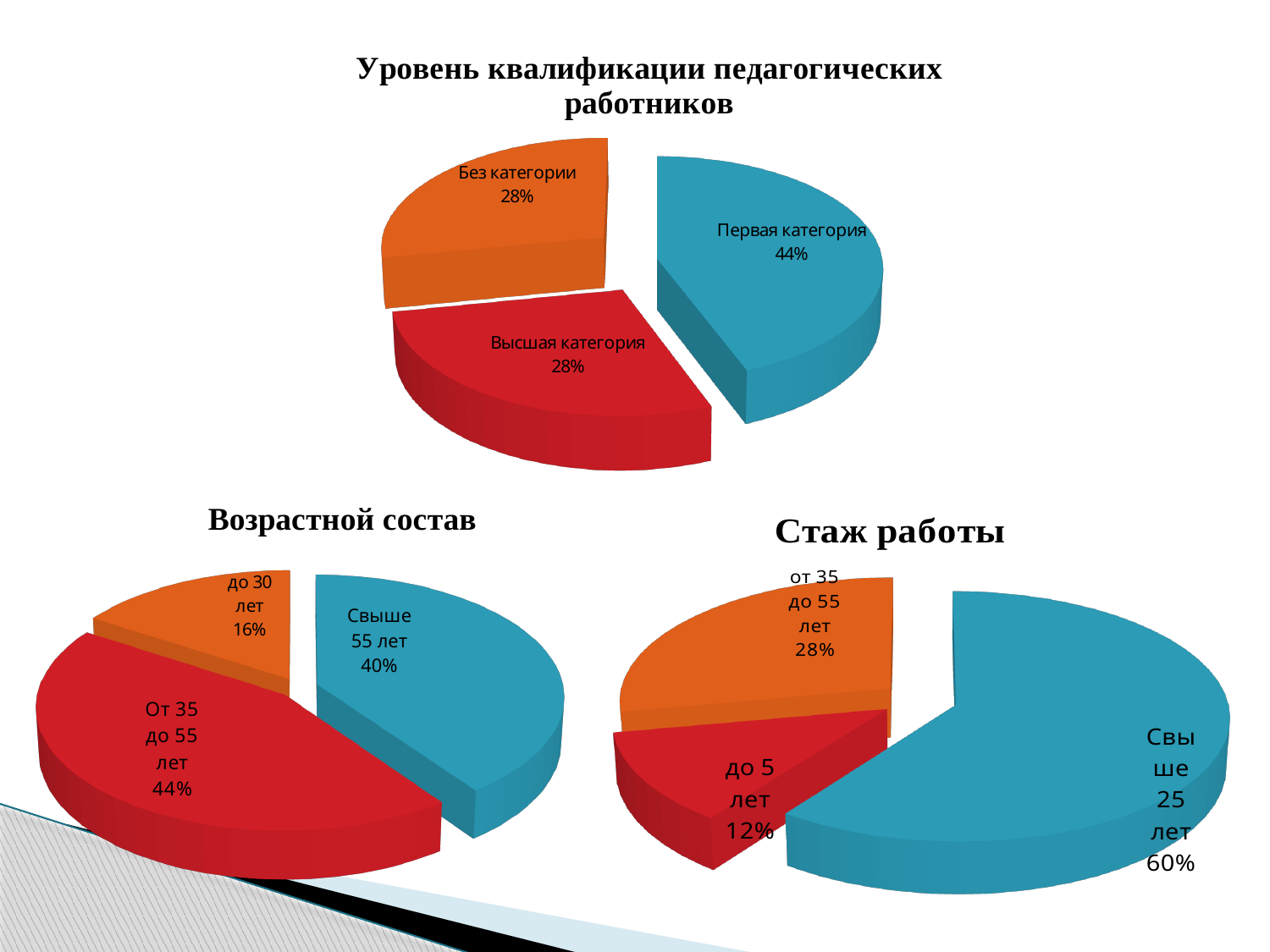
In the chart titled 'Возрастной состав', which is larger: 'Свыше 55 лет' or 'От 35 до 55 лет'? От 35 до 55 лет What kind of chart is the chart titled 'Стаж работы'? Pie chart How many charts are shown on the slide? 3 In the chart titled 'Возрастной состав', which age group has the smallest slice? до 30 лет In the chart titled 'Стаж работы', what share is labelled for 'Свыше 25 лет'? 60% In the chart titled 'Уровень квалификации педагогических работников', which category has the largest slice? Первая категория In the chart titled 'Стаж работы', what is the difference between 'Свыше 25 лет' and 'до 5 лет'? 48% In the chart titled 'Уровень квалификации педагогических работников', what share is labelled for 'Первая категория'? 44% In the chart titled 'Стаж работы', which category has the smallest slice? до 5 лет In the chart titled 'Возрастной состав', what share is labelled for 'до 30 лет'? 16% In the chart titled 'Уровень квалификации педагогических работников', how many slices does the pie have? 3 In the chart titled 'Уровень квалификации педагогических работников', what is the difference between 'Первая категория' and 'Высшая категория'? 16%